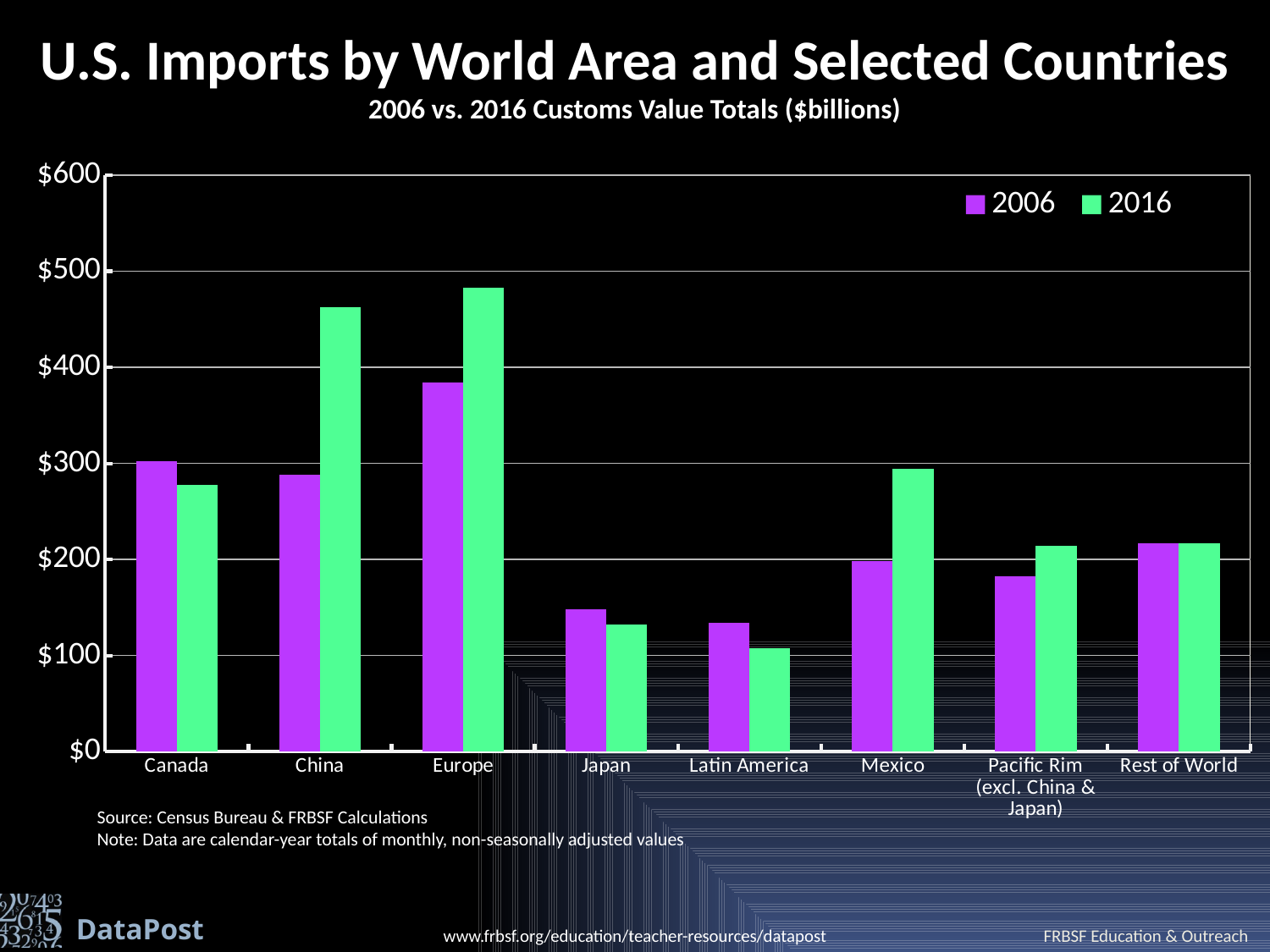
How many world areas or countries are shown on the x axis? 8 Is the 2006 value for Pacific Rim (excl. China & Japan) greater or less than $200? less Is the 2016 value for Canada greater or less than $300? less How many series does the legend list? 2 Which area has the highest 2016 import value? Europe Which area has the lowest 2016 import value? Latin America Is the 2016 value for China greater or less than $400? greater For Canada, which year has the larger import value, 2006 or 2016? 2006 What kind of chart is shown on the slide? bar chart Which colour represents the 2016 series in the legend? green For China, which year has the larger import value, 2006 or 2016? 2016 Which area has the highest 2006 import value? Europe